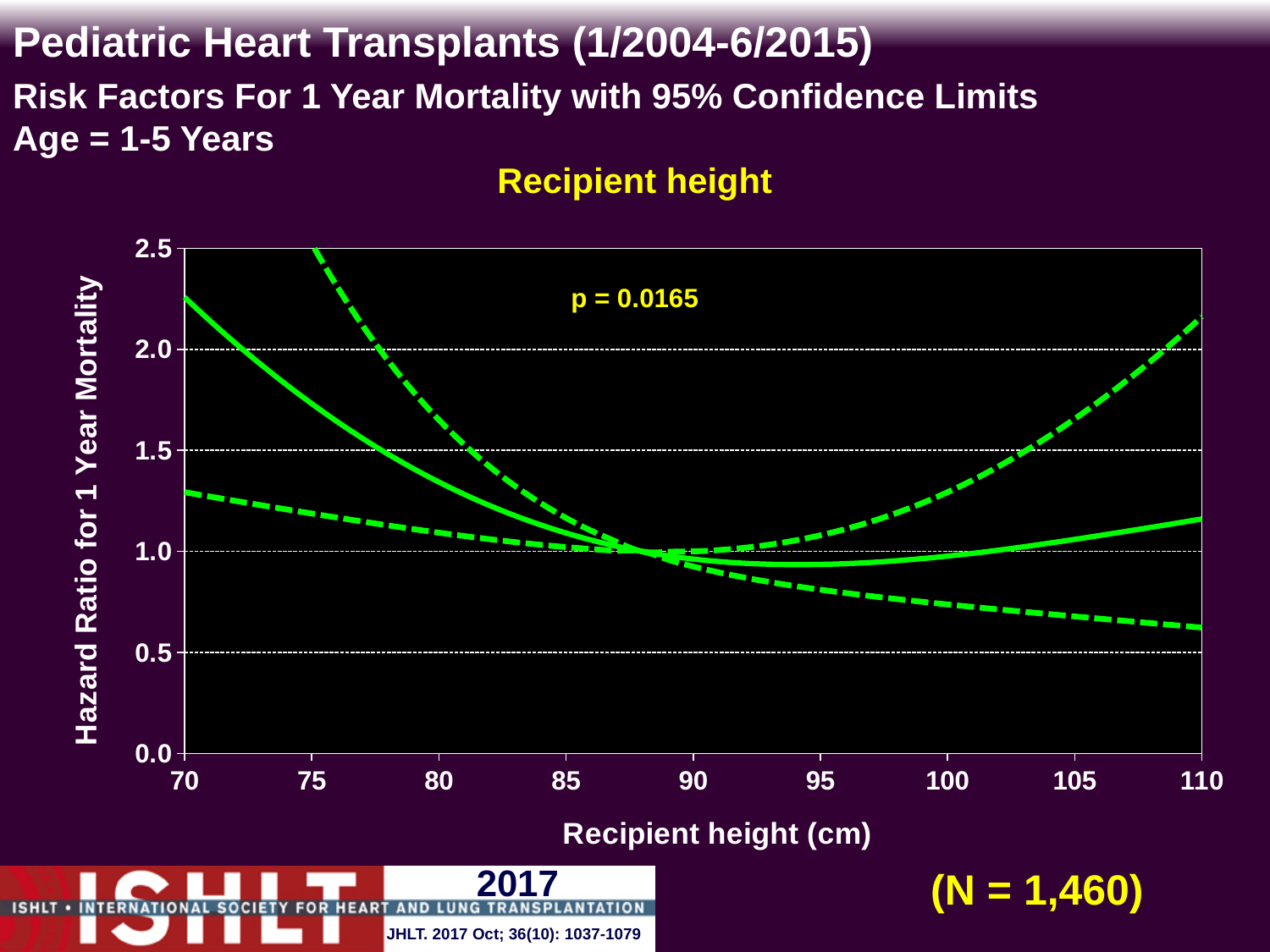
What sample size (N) is shown on the slide? N = 1,460 Is the lower 95% confidence limit (lower dashed line) at a recipient height of 70 cm greater or less than 1.0? greater Is the upper 95% confidence limit (upper dashed line) at a recipient height of 110 cm greater or less than 2.0? greater What kind of chart is shown on the slide? line chart Does the hazard ratio (solid line) rise or fall as recipient height increases from 70 cm to 90 cm? fall Is the hazard ratio (solid line) at a recipient height of 70 cm greater or less than 2.0? greater What p-value is printed on the chart? p = 0.0165 Does the upper 95% confidence limit (upper dashed line) rise or fall as recipient height increases from 95 cm to 110 cm? rise How many lines are plotted on the chart? 3